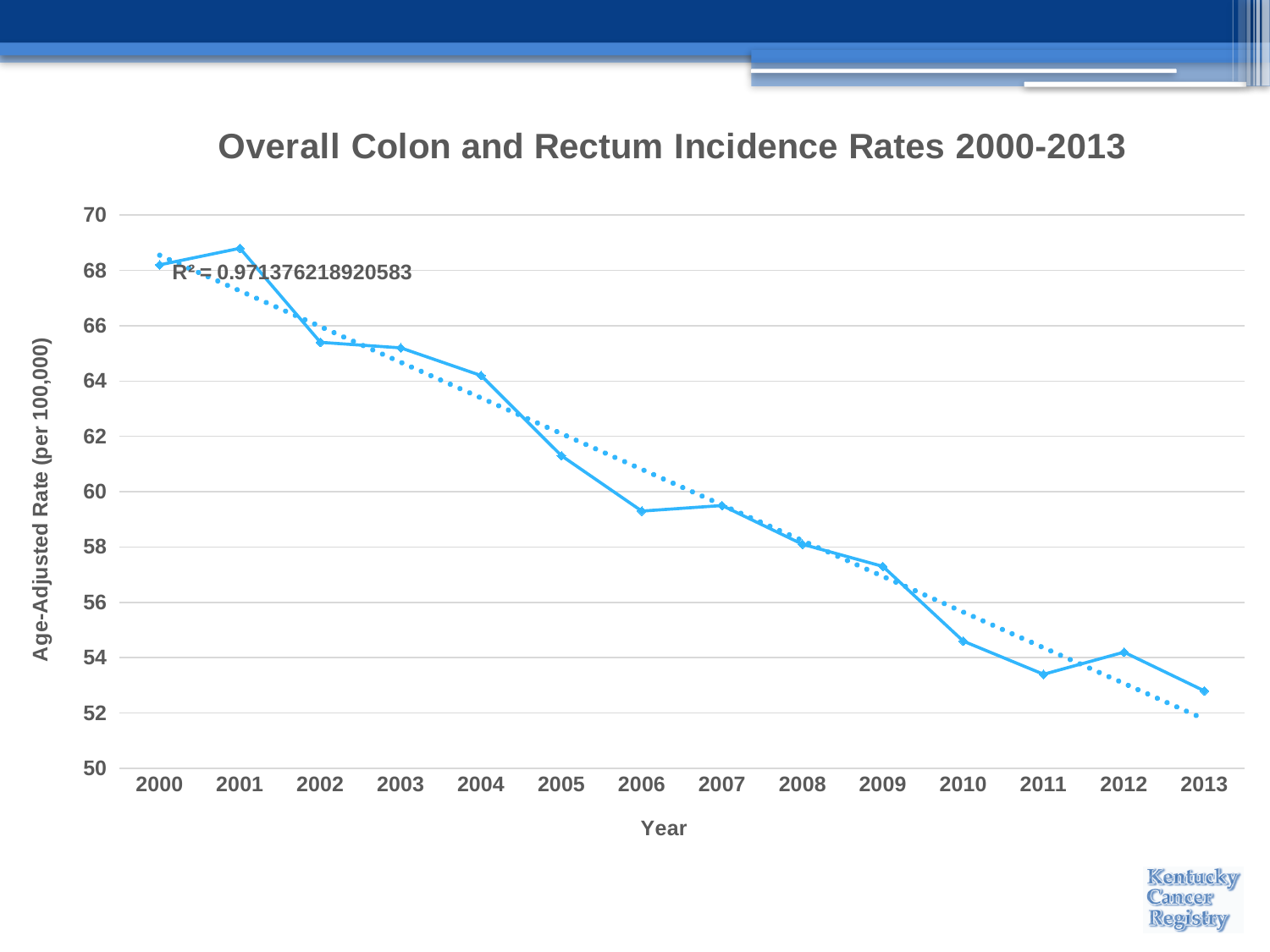
What R² value is printed on the chart? R² = 0.971376218920583 Which year has the highest age-adjusted incidence rate? 2001 Which year has the higher incidence rate, 2011 or 2012? 2012 Which year has the lowest age-adjusted incidence rate? 2013 Is the value for 2010 greater or less than 56? less What is the title of the chart? Overall Colon and Rectum Incidence Rates 2000-2013 How many years are plotted along the x axis? 14 Is the value for 2005 greater or less than 62? less Is the value for 2013 greater or less than 52? greater Do the incidence rates generally rise or fall from 2000 to 2013? fall What kind of chart is shown on the slide? line chart